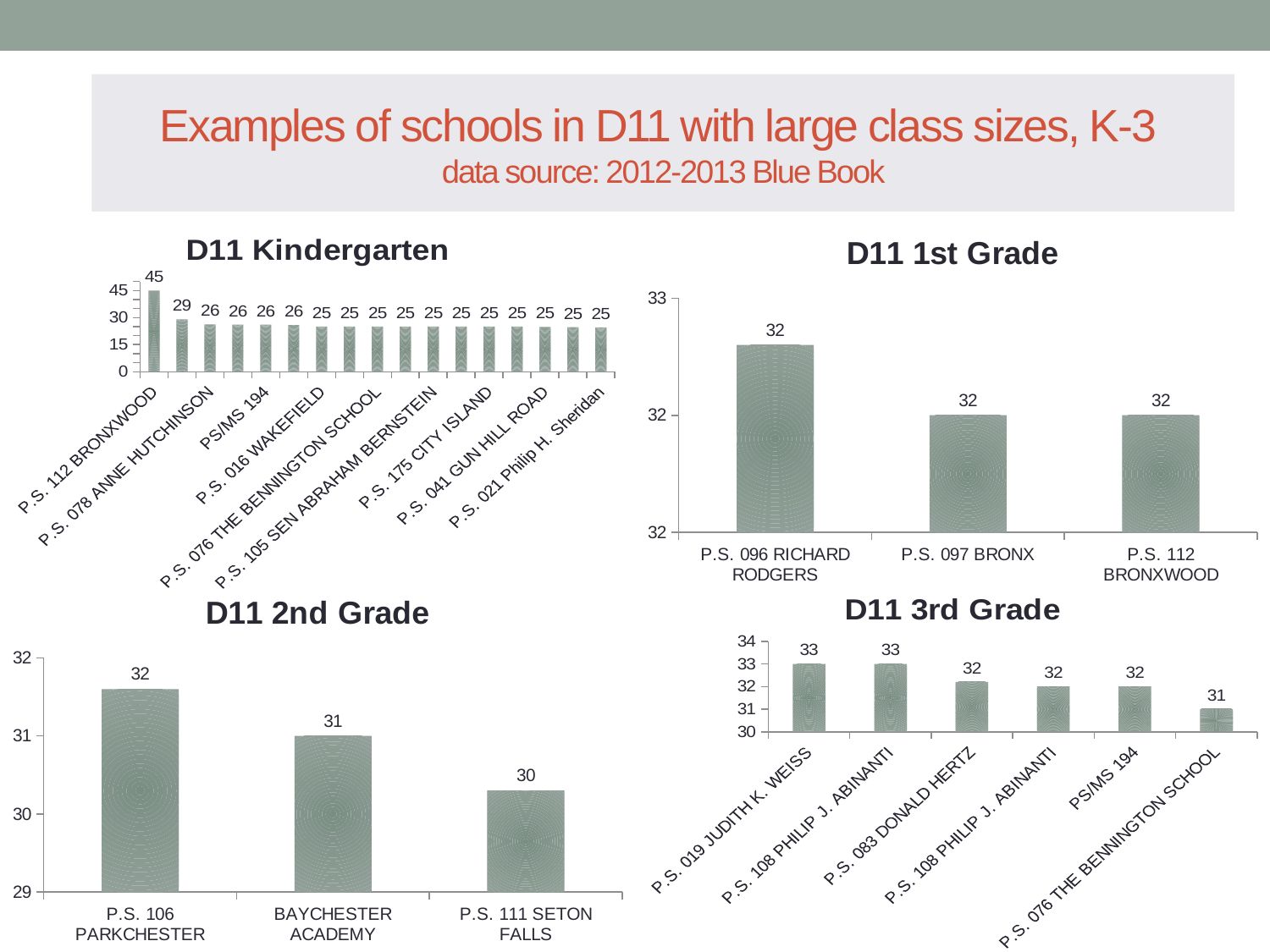
In the D11 2nd Grade chart, do the values rise or fall from left to right? fall In the D11 2nd Grade chart, what is the difference between the values for P.S. 106 PARKCHESTER and P.S. 111 SETON FALLS? 2 In the D11 3rd Grade chart, what is the value for P.S. 076 THE BENNINGTON SCHOOL? 31 In the D11 Kindergarten chart, what is the difference between the values for P.S. 112 BRONXWOOD and P.S. 078 ANNE HUTCHINSON? 19 In the D11 2nd Grade chart, which school has the lowest value? P.S. 111 SETON FALLS In the D11 2nd Grade chart, what is the value for BAYCHESTER ACADEMY? 31 In the D11 3rd Grade chart, how many schools are shown? 6 In the D11 1st Grade chart, how many schools are shown? 3 In the D11 Kindergarten chart, what is the value for P.S. 078 ANNE HUTCHINSON? 26 In the D11 Kindergarten chart, which school has the highest value? P.S. 112 BRONXWOOD What kind of chart is the D11 2nd Grade chart? bar chart In the D11 Kindergarten chart, what is the value for P.S. 112 BRONXWOOD? 45